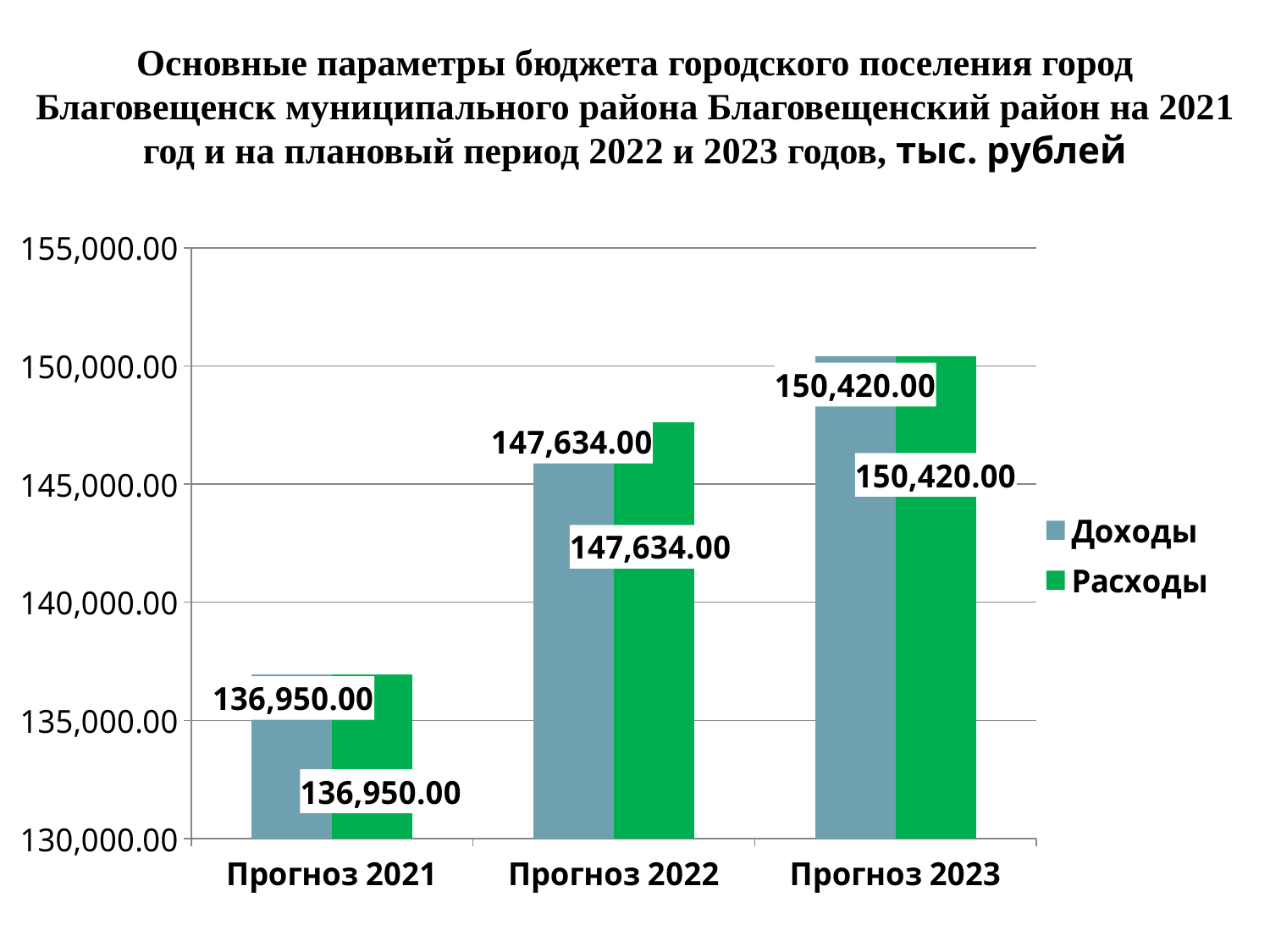
How many series does the legend list? 2 What is the value of Доходы for Прогноз 2023? 150,420.00 Is the value of Расходы for Прогноз 2023 greater or less than 145,000.00? greater What is the value of Расходы for Прогноз 2022? 147,634.00 Which category has the highest value for Расходы? Прогноз 2023 What is the difference between Доходы for Прогноз 2023 and Доходы for Прогноз 2021? 13,470.00 Which is larger: Доходы for Прогноз 2022 or Доходы for Прогноз 2021? Прогноз 2022 How many categories are shown on the x axis? 3 What is the difference between Расходы for Прогноз 2022 and Расходы for Прогноз 2021? 10,684.00 What kind of chart is shown on the slide? bar chart Which category has the lowest value for Доходы? Прогноз 2021 What is the value of Доходы for Прогноз 2021? 136,950.00